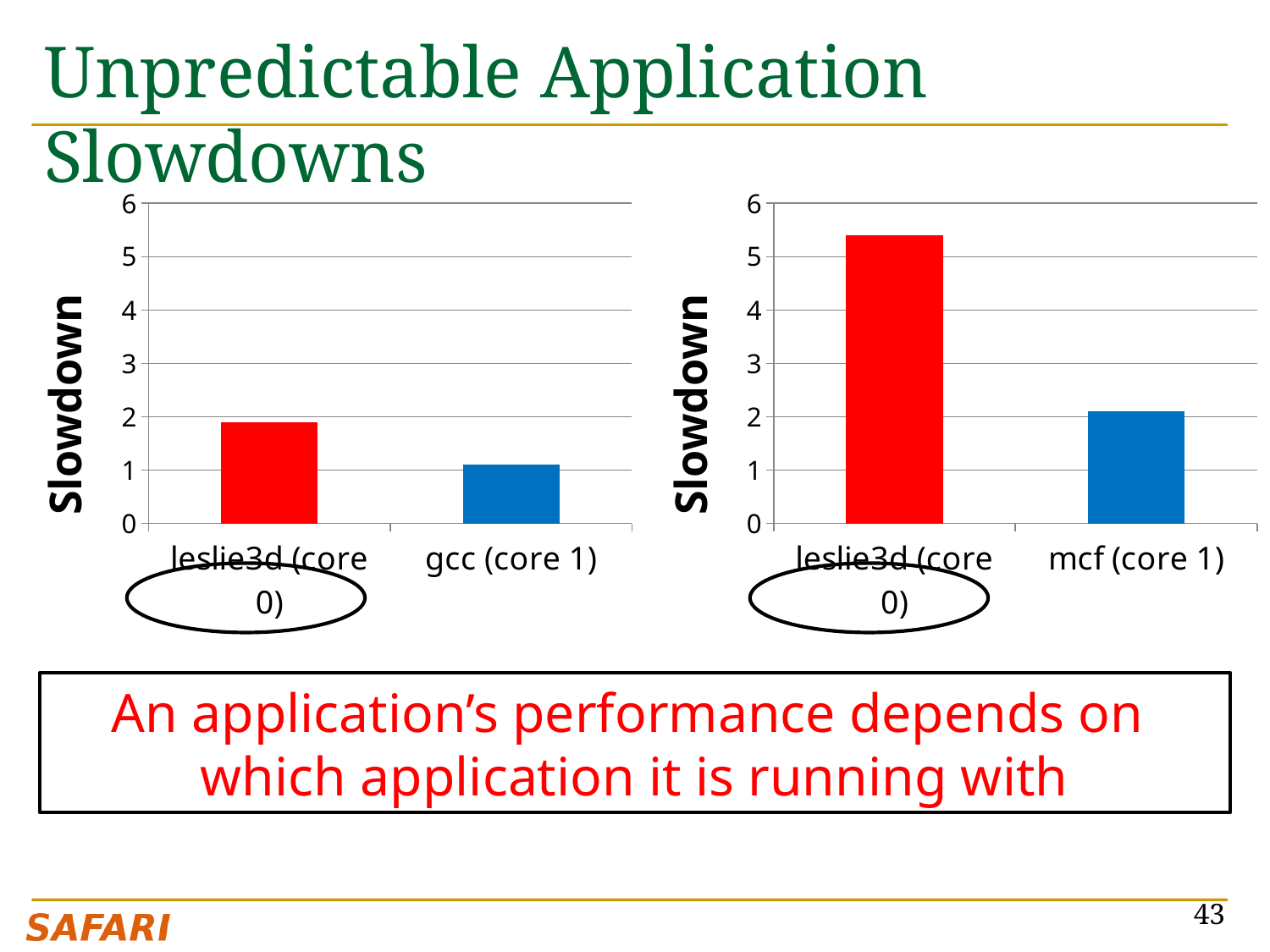
In the left chart, which category has the highest slowdown? leslie3d (core 0) In the right chart, is the slowdown for leslie3d (core 0) greater or less than 5? greater What kind of chart is the left chart on the slide? bar chart Which is larger: the slowdown for leslie3d (core 0) in the left chart or in the right chart? right chart In the right chart, is the slowdown for mcf (core 1) greater or less than 3? less In the left chart, which category has the lowest slowdown? gcc (core 1) In the right chart, which category has the highest slowdown? leslie3d (core 0) In the right chart, which category has the lowest slowdown? mcf (core 1) What is the y-axis label on the right chart? Slowdown How many categories does the right chart show? 2 How many categories does the left chart show? 2